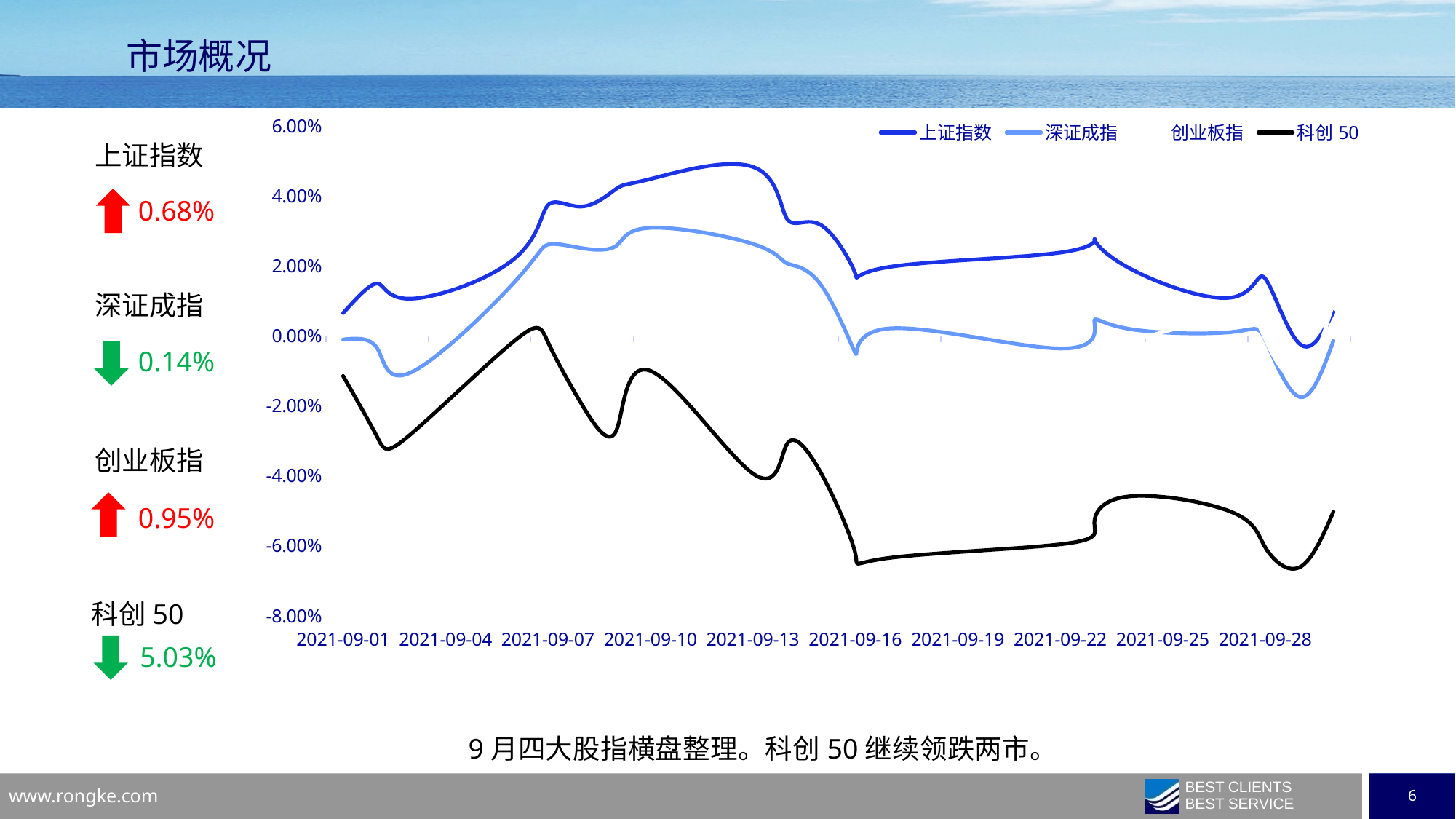
Is the value for 科创 50 around 2021-09-16 greater or less than -6.00%? less Which series reaches the lowest value on the chart? 科创 50 Is the value for 上证指数 around 2021-09-13 greater or less than 4.00%? greater What kind of chart is shown on the slide? line chart How many date labels are shown on the x axis? 10 What is the highest tick value shown on the y axis? 6.00% Does the 科创 50 line rise or fall between 2021-09-13 and 2021-09-16? fall Is the value for 深证成指 around 2021-09-10 greater or less than 2.00%? greater How many series does the chart legend list? 4 On 2021-09-19, which is higher, 上证指数 or 科创 50? 上证指数 Which series reaches the highest value on the chart? 上证指数